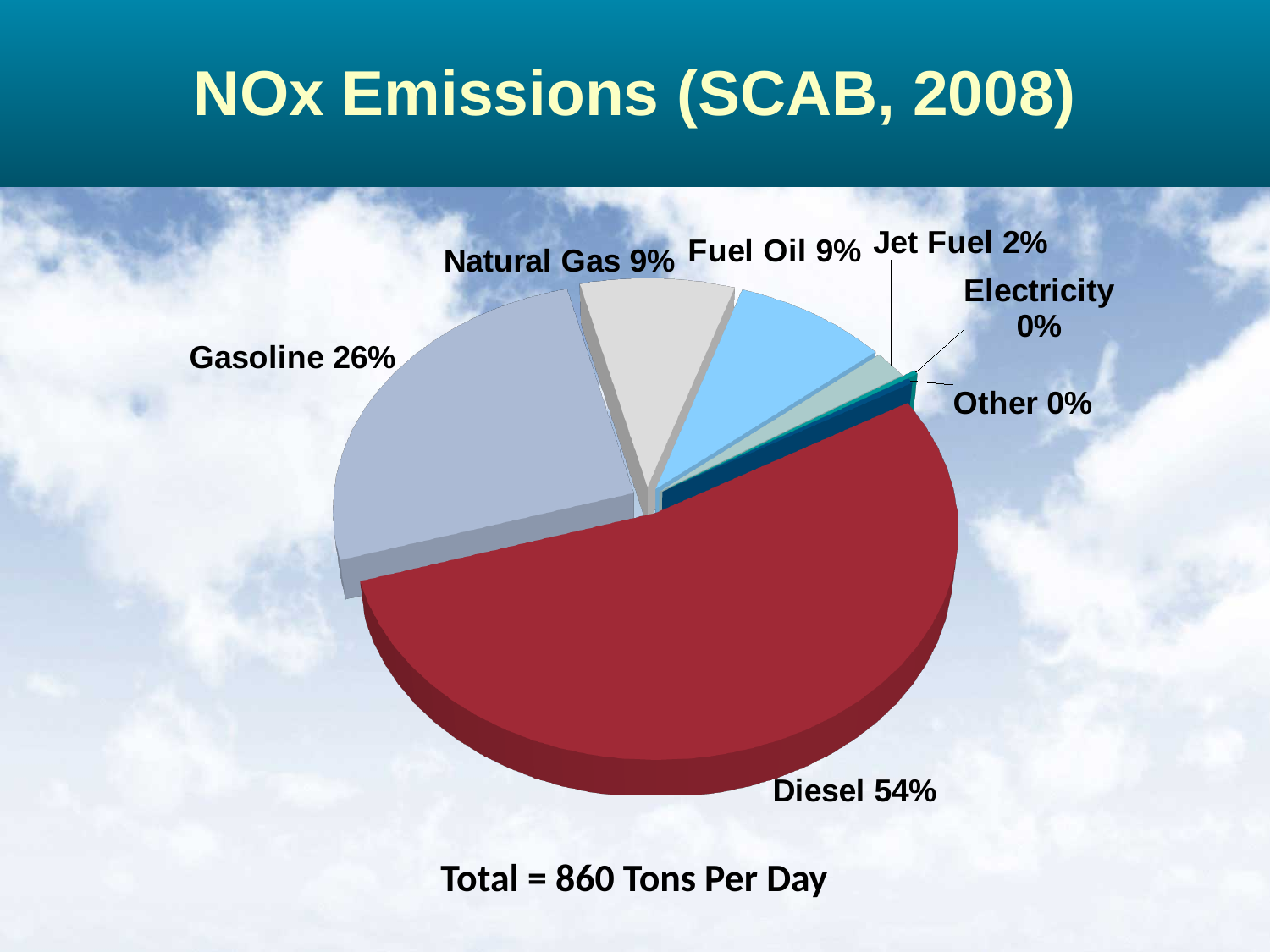
What is the total NOx emissions stated below the chart? 860 Tons Per Day What is the title of the chart? NOx Emissions (SCAB, 2008) What share of NOx emissions comes from Gasoline? 26% How many categories are labelled on the pie chart? 7 What share of NOx emissions comes from Electricity? 0% What share of NOx emissions comes from Jet Fuel? 2% What kind of chart is shown on the slide? Pie chart What share of NOx emissions comes from Natural Gas? 9% What is the difference in percentage points between the Diesel and Gasoline shares? 28 What share of NOx emissions comes from Diesel? 54% Which has a larger share of NOx emissions, Gasoline or Fuel Oil? Gasoline Which category has the largest share of NOx emissions? Diesel